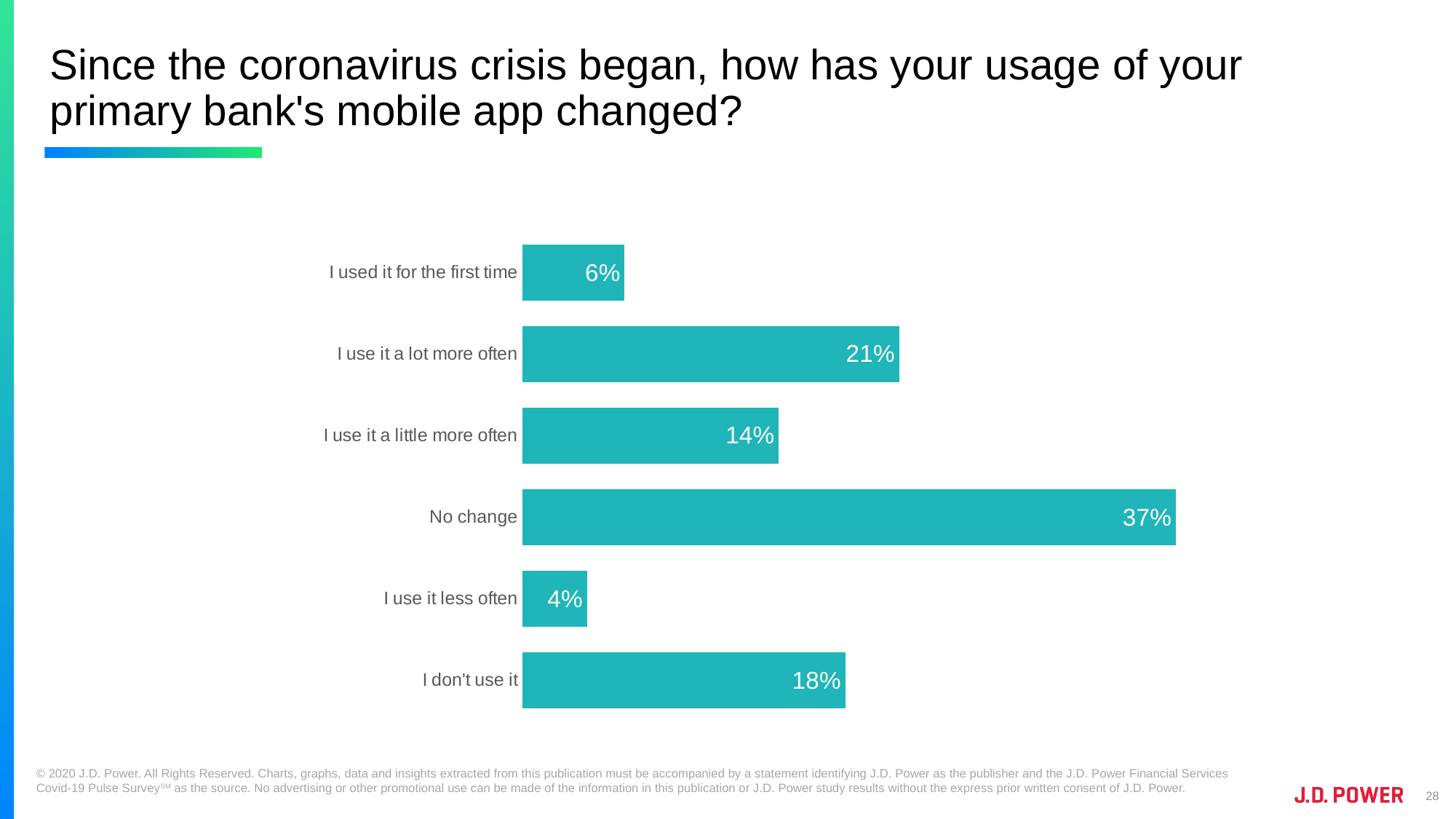
Which is larger: "I use it a lot more often" or "I don't use it"? I use it a lot more often Which response has the highest percentage? No change What percentage of respondents said "I don't use it"? 18% What percentage of respondents said "No change"? 37% Which response has the lowest percentage? I use it less often What percentage of respondents said "I use it a lot more often"? 21% What colour are the bars in the chart? Teal What percentage of respondents said "I used it for the first time"? 6% What is the difference in percentage points between "I don't use it" and "I use it a little more often"? 4 How many response categories are shown in the chart? 6 What type of chart is shown on the slide? Bar chart What is the difference in percentage points between "No change" and "I use it a lot more often"? 16